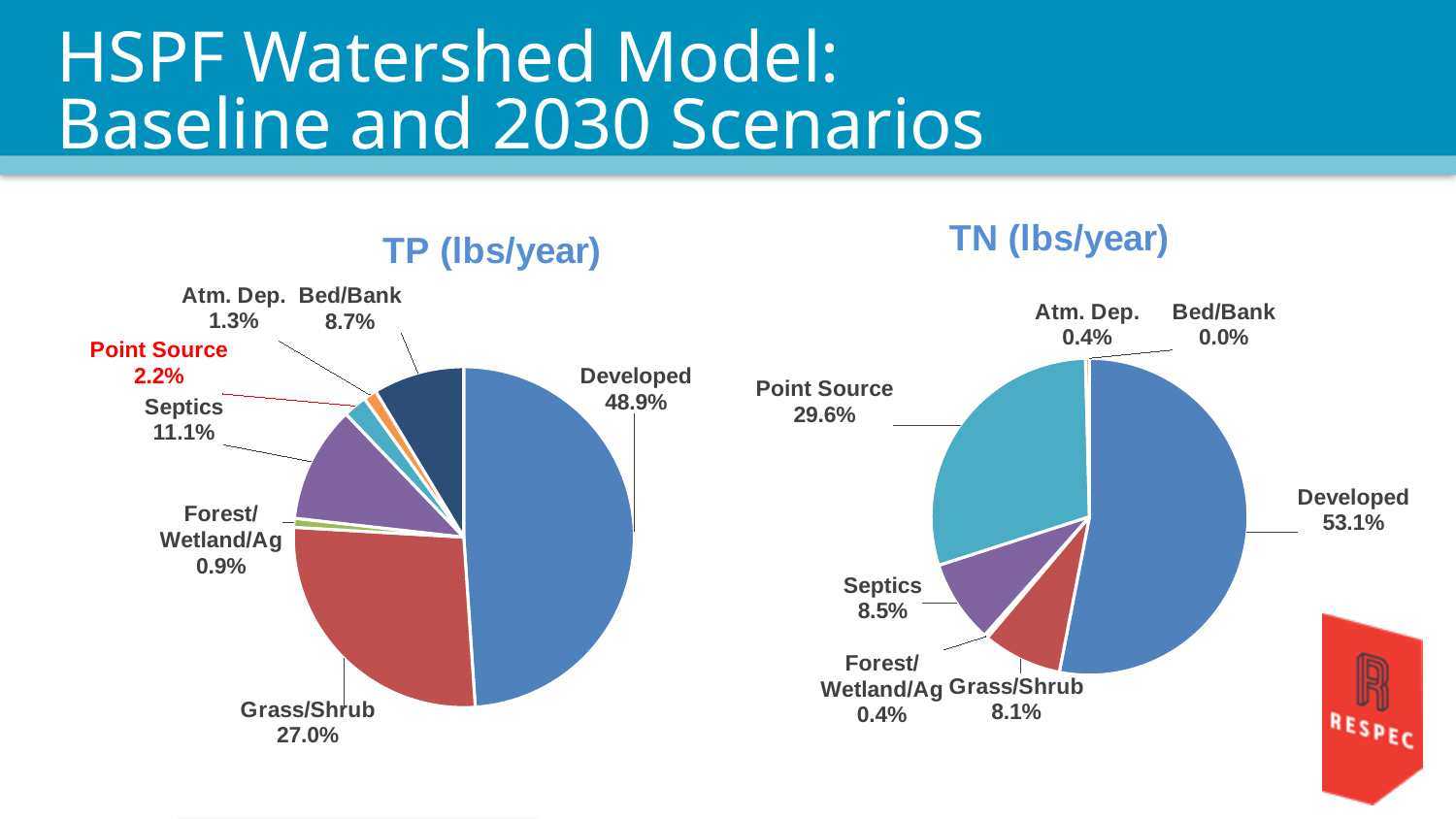
In the TP (lbs/year) chart, which category has the largest share? Developed In the TN (lbs/year) chart, which category has the smallest share? Bed/Bank In the TN (lbs/year) chart, what is the value for Bed/Bank? 0.0% In the TP (lbs/year) chart, what is the difference between the Developed and Grass/Shrub shares? 21.9% In the TN (lbs/year) chart, what share does Point Source account for? 29.6% In the TP (lbs/year) chart, what is the value for Septics? 11.1% In the TN (lbs/year) chart, which is larger, Septics or Grass/Shrub? Septics What type of chart is the TP (lbs/year) chart? Pie chart In the TP (lbs/year) chart, which category's label is shown in red text? Point Source How many categories are shown in the TN (lbs/year) pie chart? 7 In the TP (lbs/year) chart, what share does Developed account for? 48.9% In the TP (lbs/year) chart, which category has the smallest share? Forest/Wetland/Ag